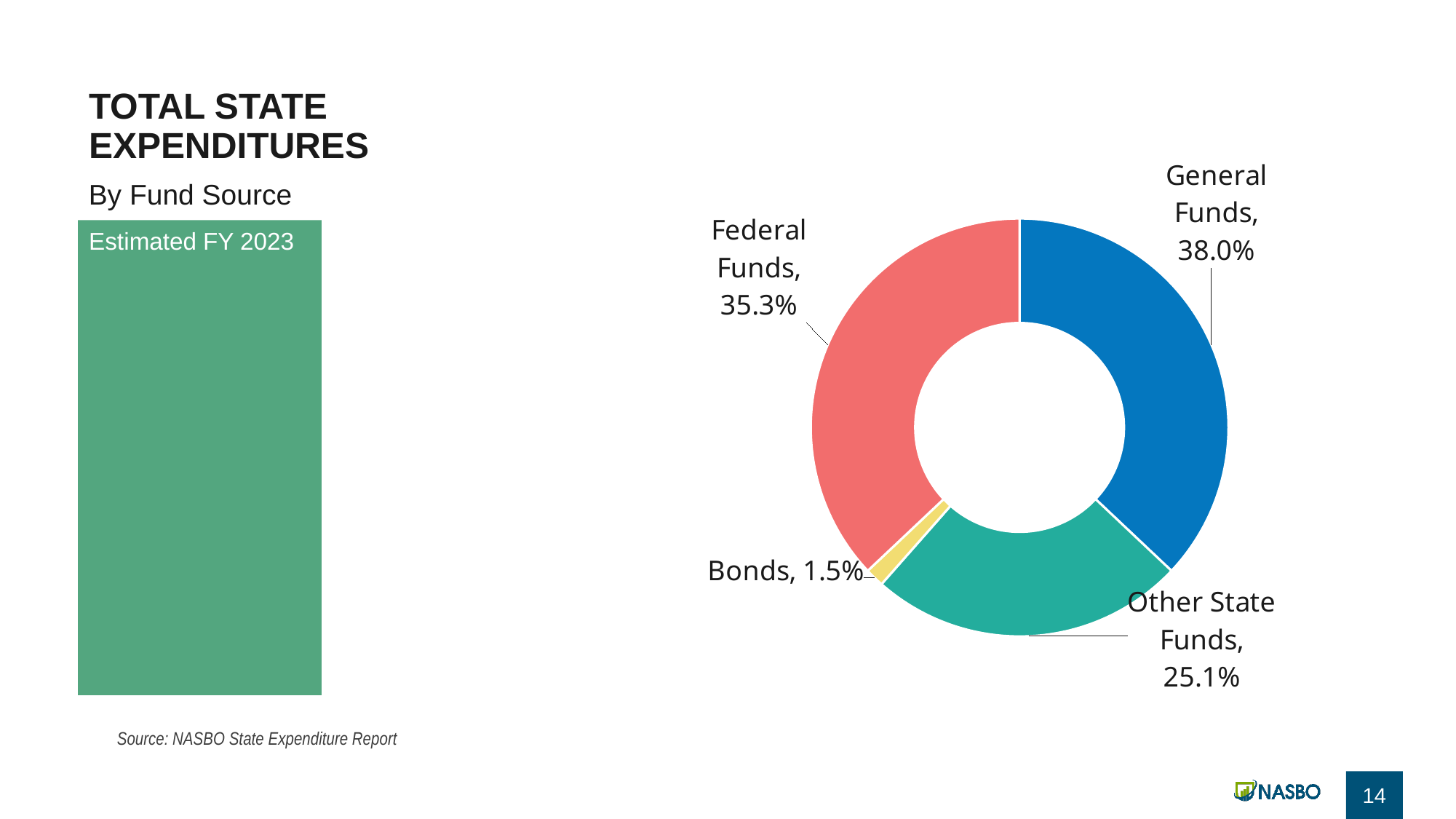
What share of total state expenditures comes from Bonds? 1.5% What share of total state expenditures comes from Other State Funds? 25.1% What is the difference in percentage points between the General Funds share and the Federal Funds share? 2.7 Which fund source has the largest share of total state expenditures? General Funds Which is larger, the share for Other State Funds or the share for Bonds? Other State Funds What share of total state expenditures comes from General Funds? 38.0% What share of total state expenditures comes from Federal Funds? 35.3% Which fund source has the smallest share of total state expenditures? Bonds What is the difference in percentage points between the Federal Funds share and the Other State Funds share? 10.2 Which fiscal year does the chart cover? Estimated FY 2023 How many fund source categories are shown in the chart? 4 What kind of chart is used to show expenditures by fund source? Doughnut (pie) chart